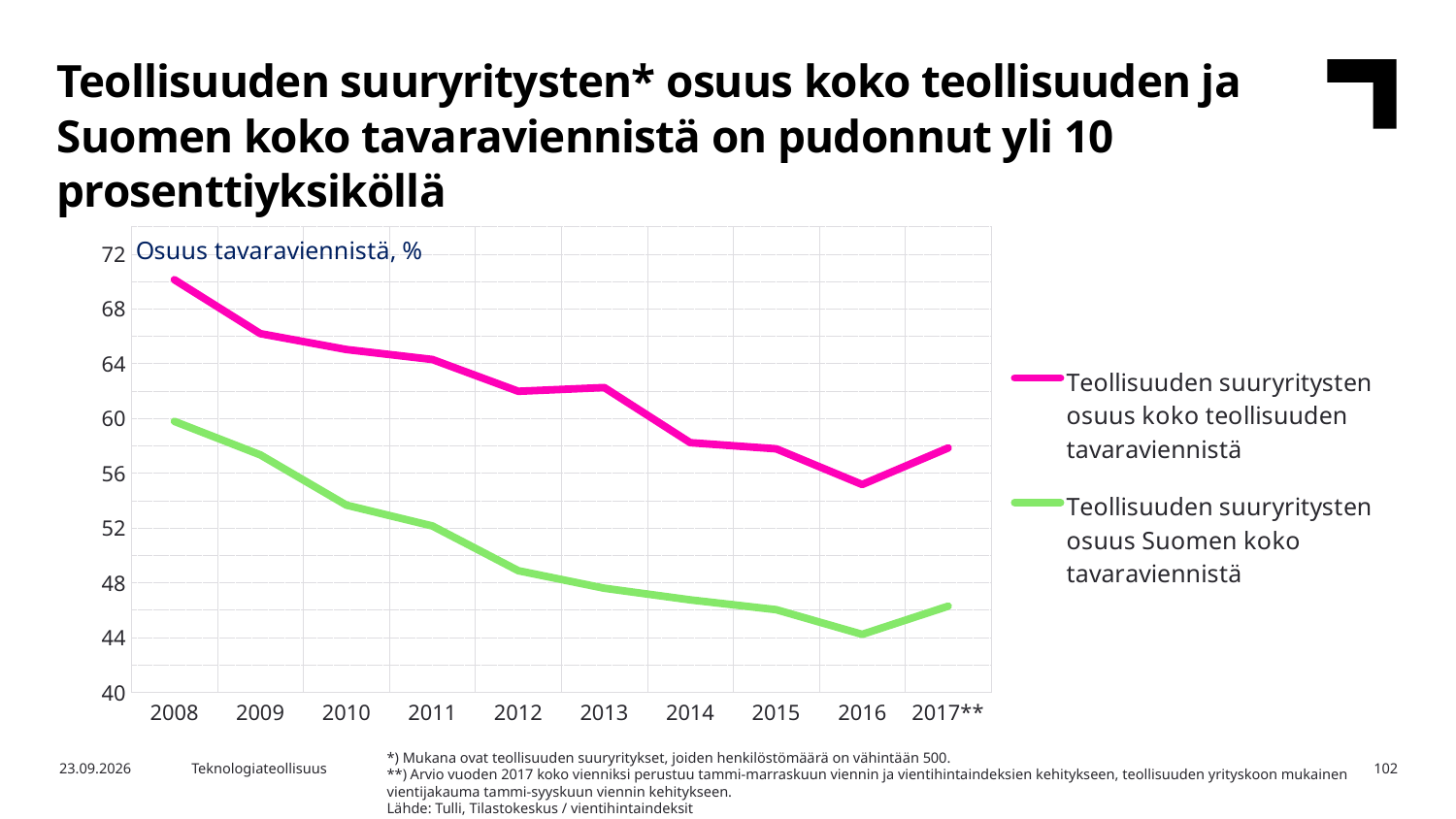
Is the 2016 value for 'Teollisuuden suuryritysten osuus Suomen koko tavaraviennistä' greater or less than 48? less In which year is the value for 'Teollisuuden suuryritysten osuus koko teollisuuden tavaraviennistä' lowest? 2016 What kind of chart is shown on the slide? line chart Which series has the higher value in 2008, 'Teollisuuden suuryritysten osuus koko teollisuuden tavaraviennistä' or 'Teollisuuden suuryritysten osuus Suomen koko tavaraviennistä'? Teollisuuden suuryritysten osuus koko teollisuuden tavaraviennistä Is the 2008 value for 'Teollisuuden suuryritysten osuus koko teollisuuden tavaraviennistä' greater or less than 68? greater What is the first year shown on the x axis? 2008 In which year is the value for 'Teollisuuden suuryritysten osuus koko teollisuuden tavaraviennistä' highest? 2008 What is the label shown inside the plot area at the top left of the chart? Osuus tavaraviennistä, % Is the 2012 value for 'Teollisuuden suuryritysten osuus koko teollisuuden tavaraviennistä' greater or less than 64? less How many series does the legend list? 2 How many years are plotted along the x axis? 10 In which year is the value for 'Teollisuuden suuryritysten osuus Suomen koko tavaraviennistä' lowest? 2016